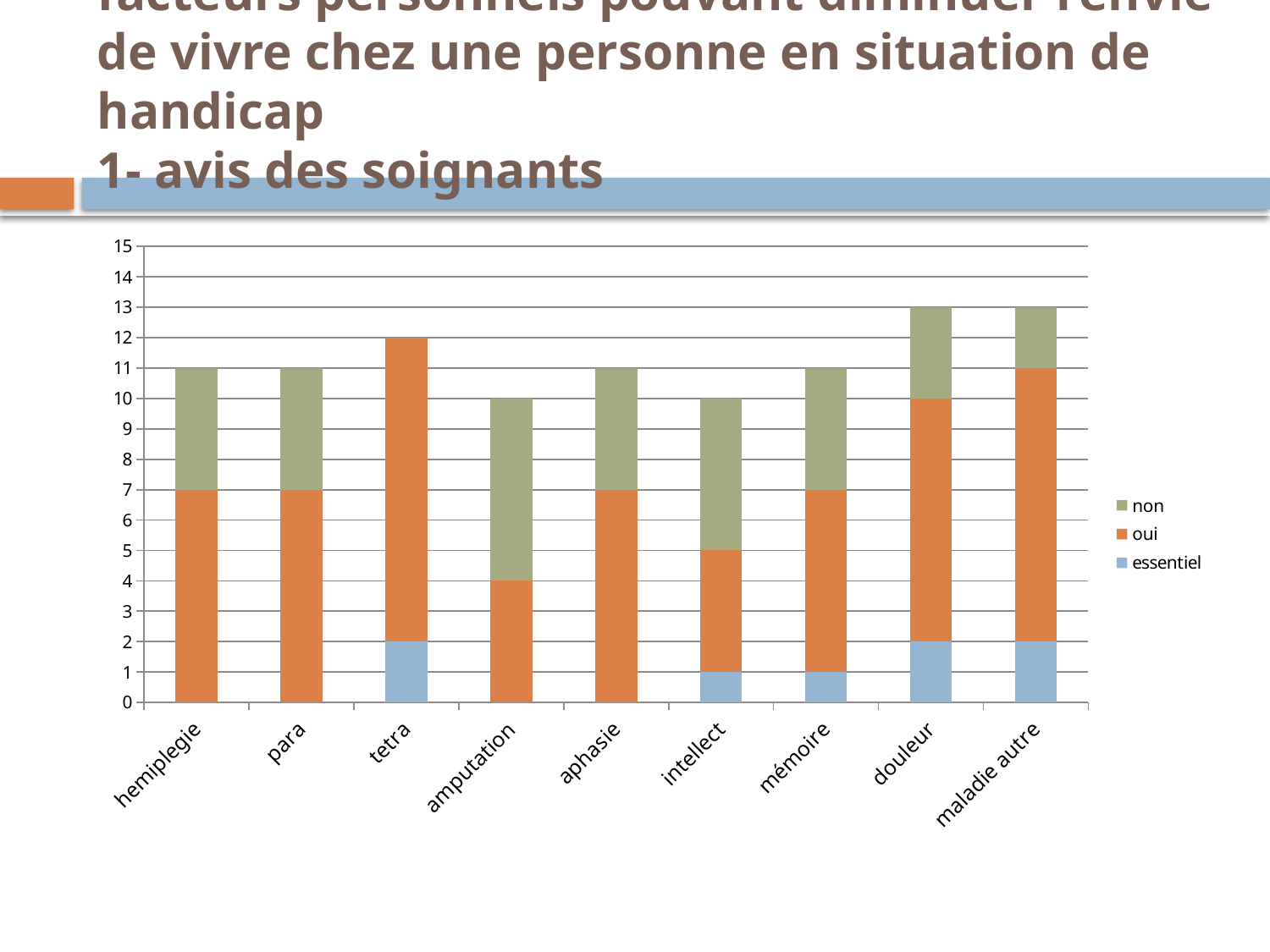
How many series does the legend list? 3 What is the value of the essentiel series for mémoire? 1 Is the total for intellect greater or less than 12? less What is the total height of the stacked bar for tetra? 12 What are the three series listed in the legend? non, oui, essentiel What is the total height of the stacked bar for douleur? 13 Which stacked bar is taller in total, tetra or amputation? tetra What is the value of the essentiel series for tetra? 2 What kind of chart is shown on the slide? stacked bar chart What is the difference between the total for douleur and the total for amputation? 3 How many categories are shown on the x axis of the chart? 9 What is the total height of the stacked bar for amputation? 10